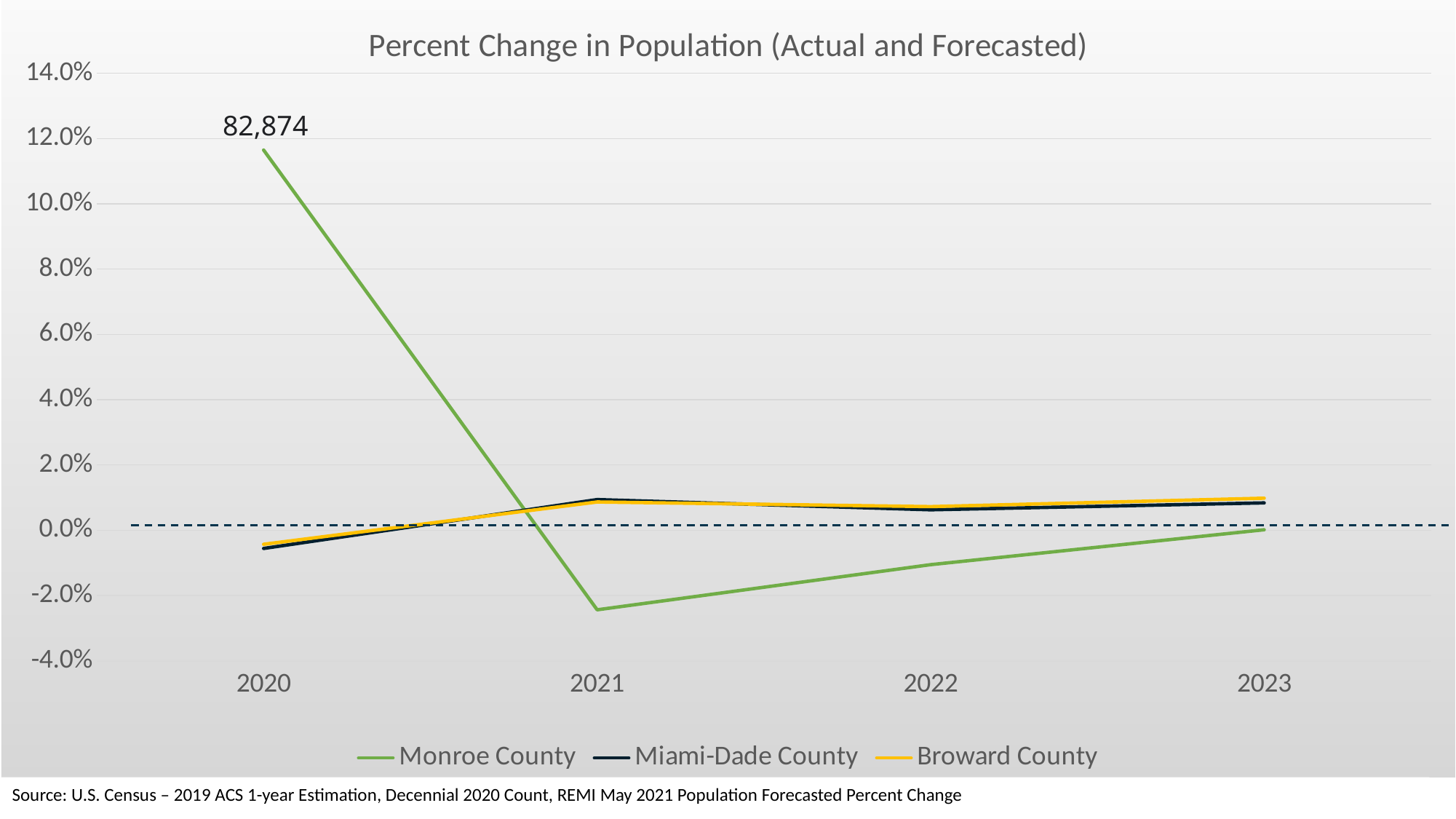
What kind of chart is shown on the slide? line chart Is the value for Monroe County in 2020 greater or less than 10.0%? greater Which county has the lowest percent change in 2021? Monroe County How many years are shown on the x axis? 4 Does the Monroe County line rise or fall from 2021 to 2023? rise What is the title of the chart? Percent Change in Population (Actual and Forecasted) Which county has the highest percent change in 2020? Monroe County Is the value for Miami-Dade County in 2020 greater or less than 0.0%? less How many series does the legend list? 3 What data label is printed next to the Monroe County point for 2020? 82,874 In 2022, which is larger: the value for Monroe County or the value for Miami-Dade County? Miami-Dade County Is the value for Monroe County in 2021 greater or less than -2.0%? less